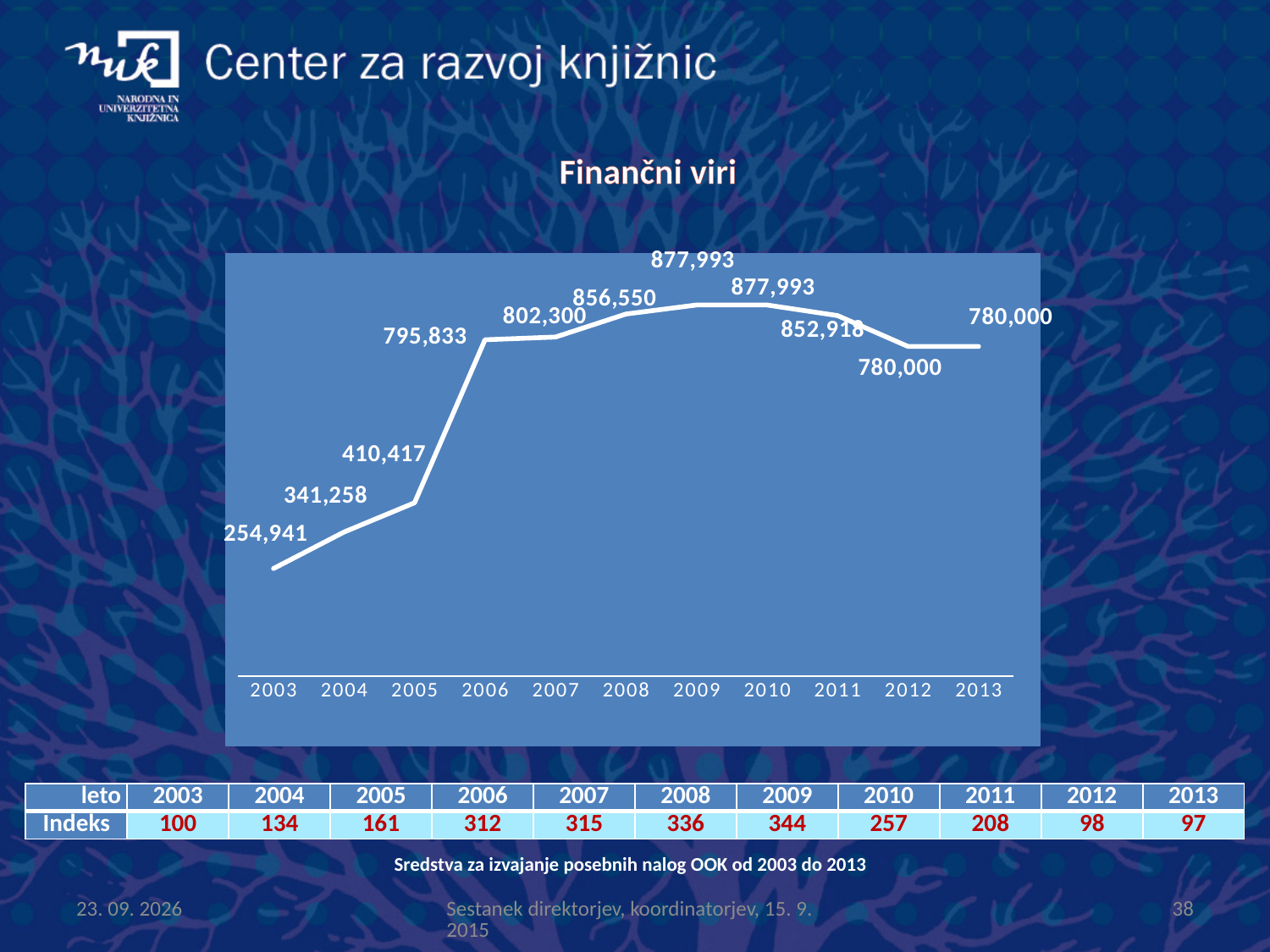
What is the value for 2006 in the Finančni viri chart? 795,833 Which year has the lowest value in the Finančni viri chart? 2003 Which year has the larger value in the Finančni viri chart, 2005 or 2006? 2006 How many years are plotted in the Finančni viri chart? 11 What is the difference between the values for 2006 and 2005 in the Finančni viri chart? 385,416 What is the value for 2003 in the Finančni viri chart? 254,941 Do the values in the Finančni viri chart rise or fall from 2003 to 2009? rise What kind of chart is the Finančni viri chart? line chart What is the highest value shown in the Finančni viri chart? 877,993 What is the value for 2013 in the Finančni viri chart? 780,000 What is the difference between the values for 2013 and 2003 in the Finančni viri chart? 525,059 What is the value for 2011 in the Finančni viri chart? 852,918